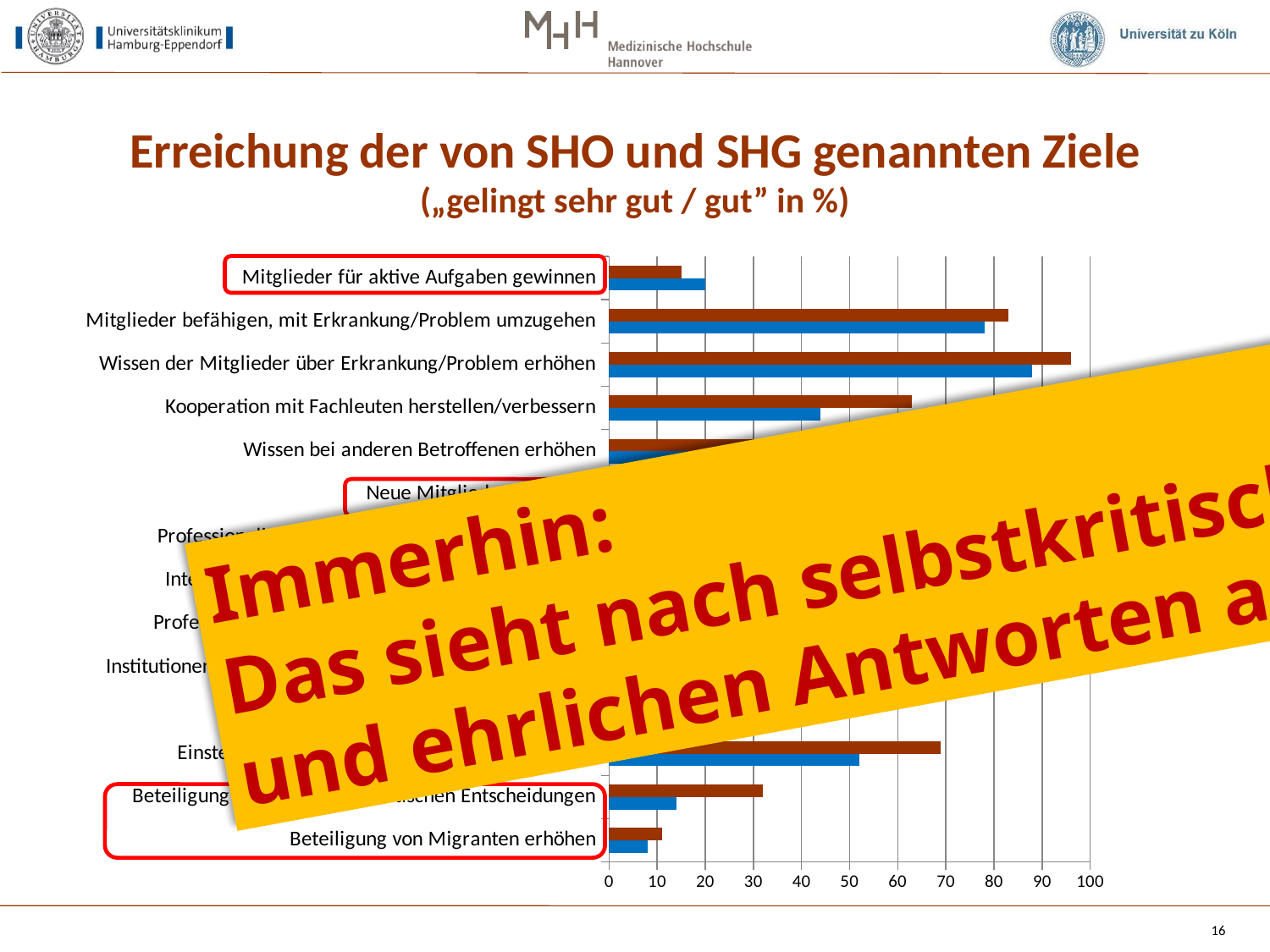
Is the brown bar for "Wissen der Mitglieder über Erkrankung/Problem erhöhen" greater or less than 90? greater What kind of chart is shown on the slide? bar chart Is the blue bar for "Kooperation mit Fachleuten herstellen/verbessern" greater or less than 50? less What is the highest value shown on the x axis of the chart? 100 For "Mitglieder für aktive Aufgaben gewinnen", which bar is longer, the brown one or the blue one? the blue one Is the blue bar for "Wissen der Mitglieder über Erkrankung/Problem erhöhen" greater or less than 80? greater For "Kooperation mit Fachleuten herstellen/verbessern", which bar is longer, the brown one or the blue one? the brown one What is the title of the chart on the slide? Erreichung der von SHO und SHG genannten Ziele How many bars are plotted for each category in the chart? 2